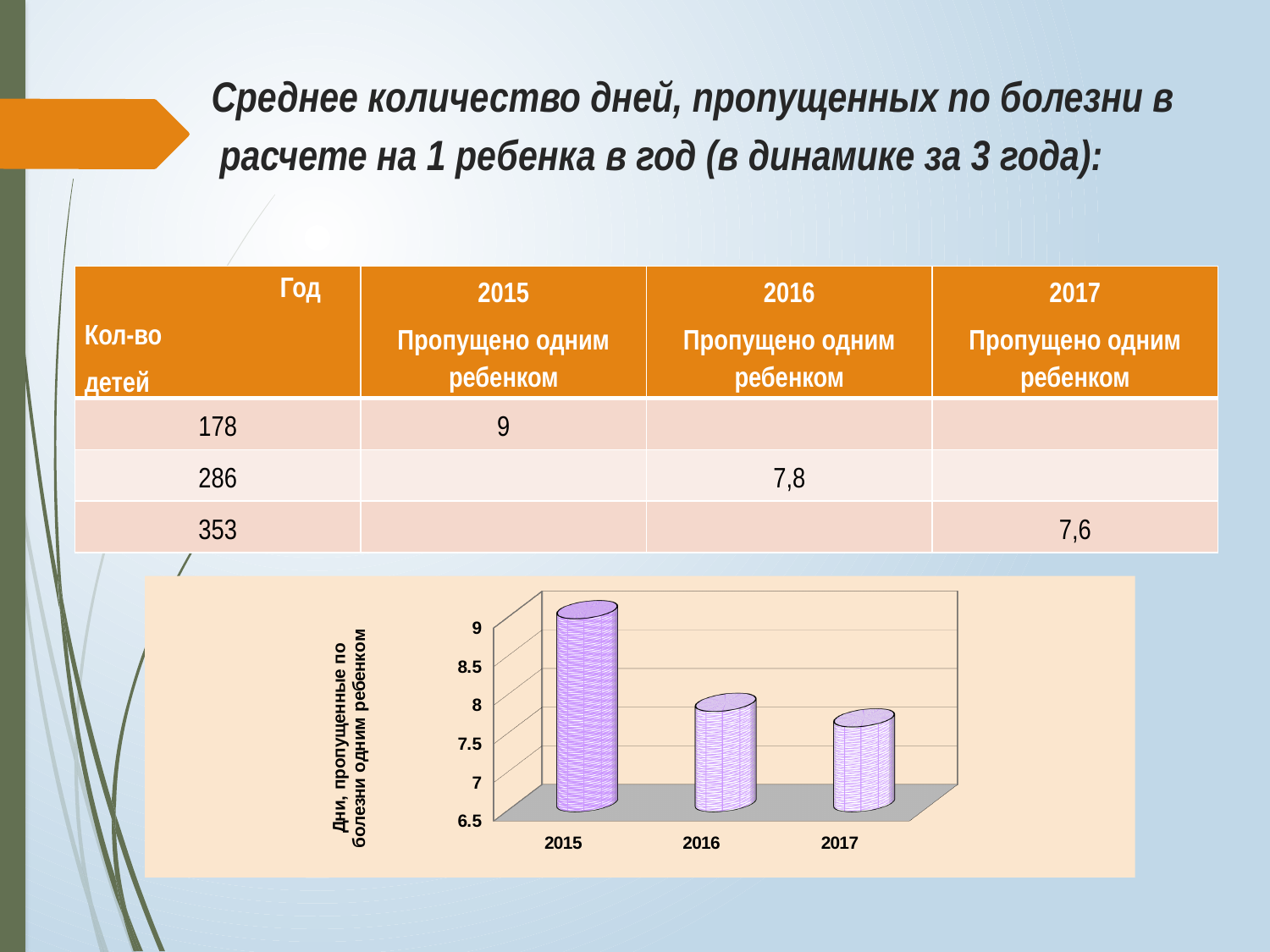
What is the difference between the values for 2015 and 2017? 1,4 What kind of chart is shown on the slide? bar chart Do the values rise or fall from 2015 to 2017 on the chart? fall What is the value for 2016 on the chart? 7,8 Which year has the highest number of days missed per child on the chart? 2015 Which is larger, the value for 2015 or the value for 2016? 2015 Is the value for 2017 greater or less than 7.5? greater How many years (categories) are plotted on the chart? 3 What is the value for 2015 on the chart? 9 Which year has the lowest number of days missed per child on the chart? 2017 Is the value for 2016 greater or less than 8? less What is the value for 2017 on the chart? 7,6